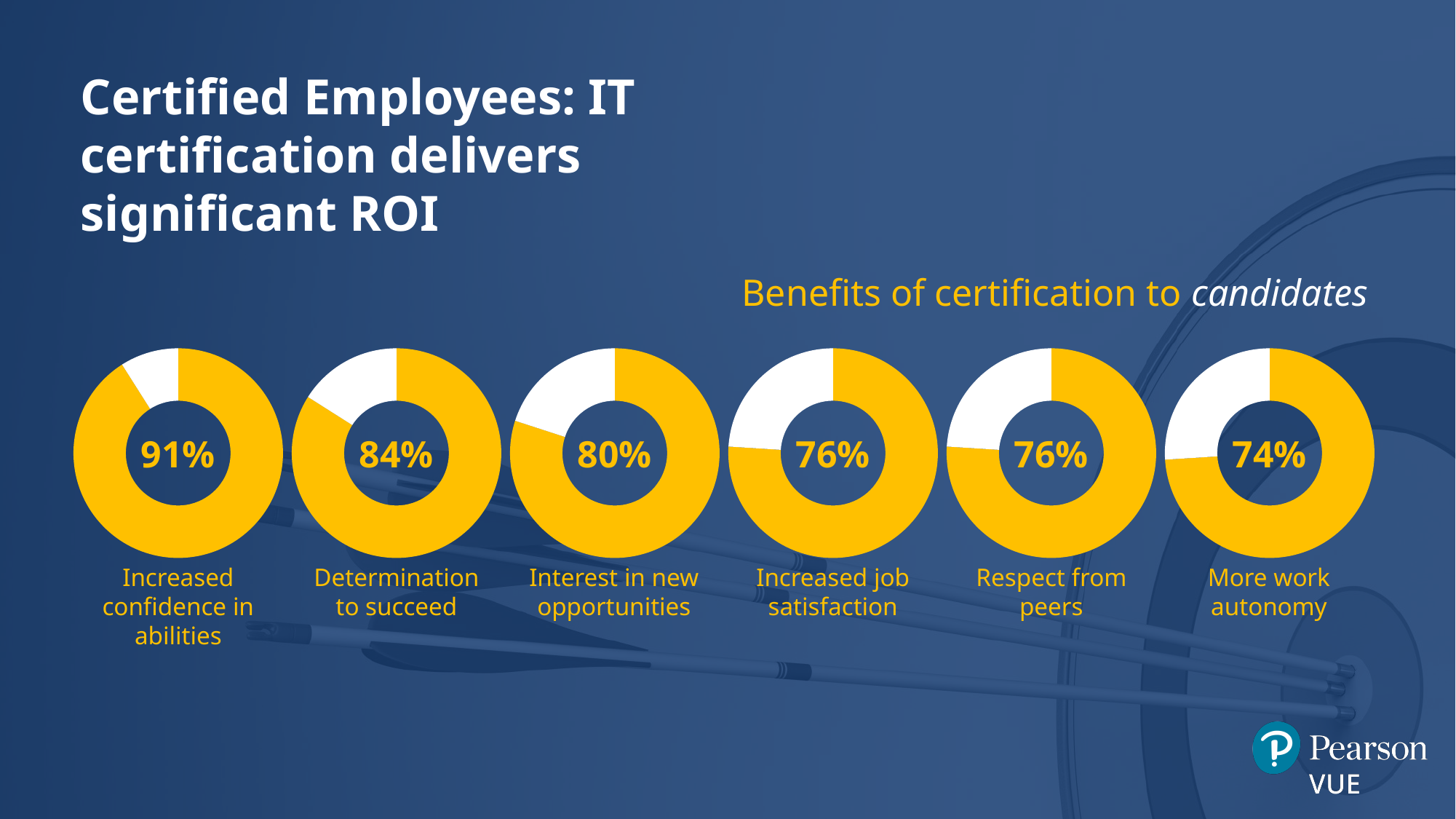
What is the difference between the percentages for 'Increased confidence in abilities' and 'More work autonomy'? 17% Which benefit has the lowest percentage? More work autonomy What percentage is shown for 'Interest in new opportunities'? 80% What is the value shown for 'Determination to succeed'? 84% What is the title above the charts? Benefits of certification to candidates Which is larger: the value for 'Increased job satisfaction' or 'Determination to succeed'? Determination to succeed Which benefit has the highest percentage? Increased confidence in abilities What value is shown for 'More work autonomy'? 74% What percentage of candidates reported increased confidence in abilities as a benefit of certification? 91% How many donut charts are shown on the slide? 6 What is the difference between 'Determination to succeed' and 'Interest in new opportunities'? 4% What kind of chart is used to show each benefit? Donut chart